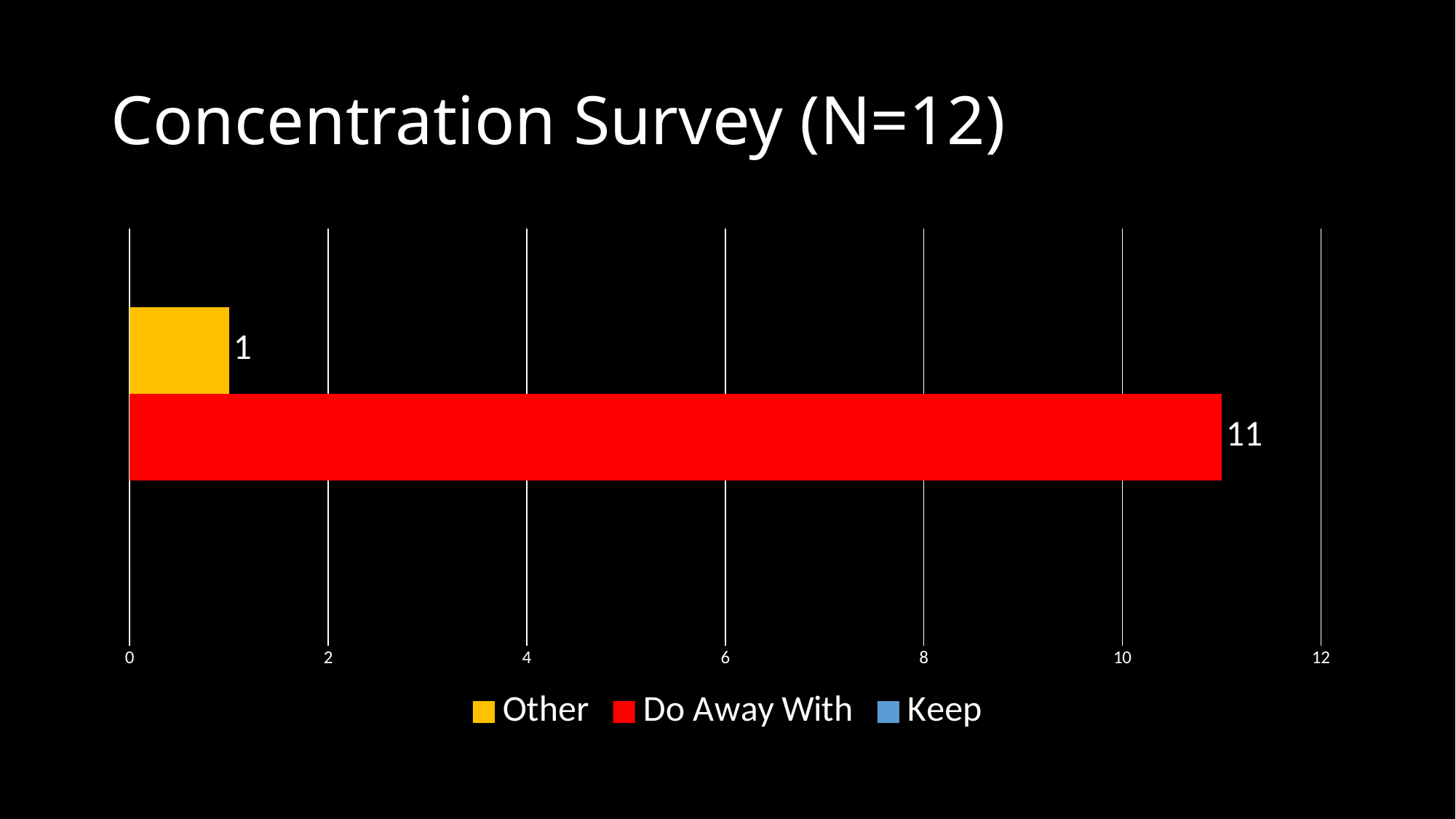
What is the highest value shown on the horizontal axis? 12 What is the value for Do Away With? 11 What is the difference between the values for Do Away With and Other? 10 Is the value for Other greater or less than 2? less What colour is the bar for Do Away With? red What is the value for Other? 1 What kind of chart is shown on the slide? bar chart How many series does the legend list? 3 Which is larger, the value for Other or the value for Do Away With? Do Away With Which series has the highest value? Do Away With What is the title of the chart? Concentration Survey (N=12) Is the value for Do Away With greater or less than 10? greater